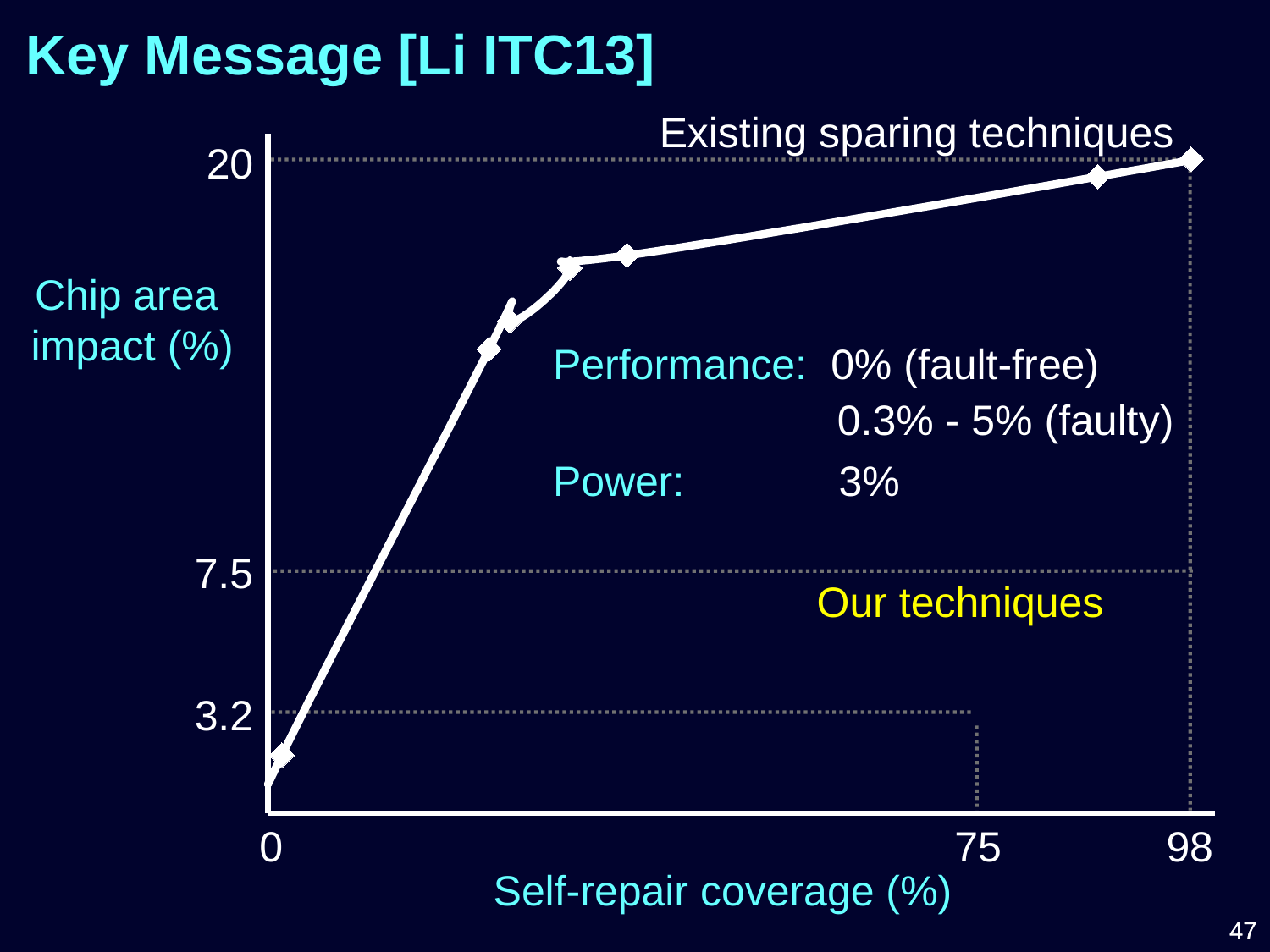
What is the highest value labelled on the x axis? 98 What is the label of the x axis? Self-repair coverage (%) Which is larger, the chip area impact at 98% coverage or at 0% coverage? 98% coverage What is the lowest value labelled on the y axis? 3.2 Is the chip area impact at 0% self-repair coverage greater or less than 3.2? less What is the label of the y axis? Chip area impact (%) Does chip area impact rise or fall as self-repair coverage increases? rise What kind of chart is shown on the slide? line chart Is the chip area impact at 75% self-repair coverage greater or less than 20? less How many tick values are labelled on the y axis? 3